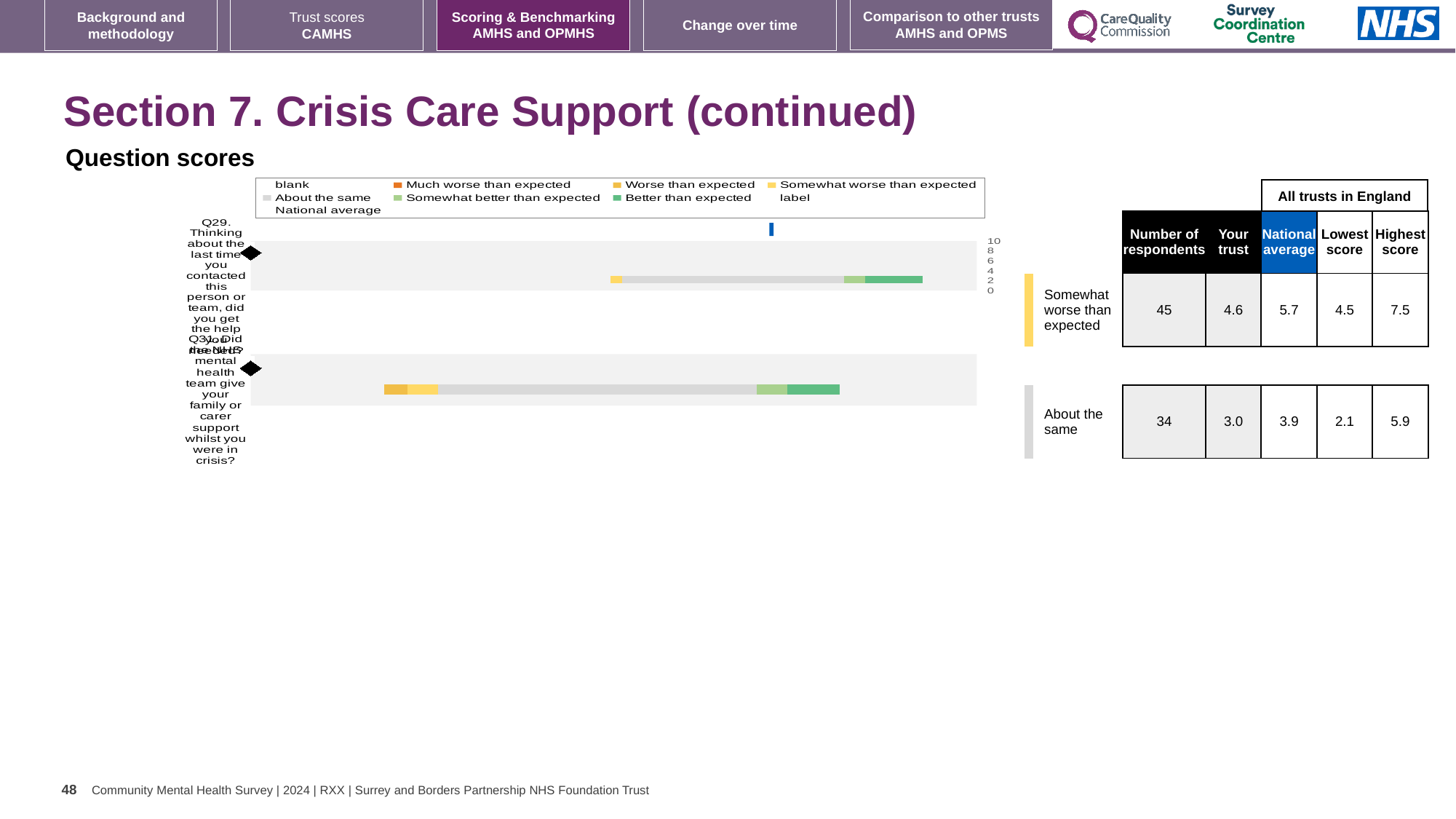
How many questions (bars) are plotted in the question scores chart? 2 What is the 'Your trust' score for Q31 (Did the NHS mental health team give your family or carer support whilst you were in crisis)? 3.0 What is the difference between the highest score (7.5) and the lowest score (4.5) for Q29? 3.0 How many respondents answered Q29? 45 What is the difference between the national average (3.9) and the 'Your trust' score (3.0) for Q31? 0.9 What is the 'Your trust' score for Q29 (Thinking about the last time you contacted this person or team, did you get the help you needed)? 4.6 For Q29, which is larger: the 'Your trust' score or the national average? National average Which benchmark category is Q29 rated as on this slide? Somewhat worse than expected What is the highest score among all trusts in England for Q31? 5.9 Which benchmark category is Q31 rated as on this slide? About the same What is the national average score for Q29? 5.7 What kind of chart is used to show the question scores on this slide? bar chart